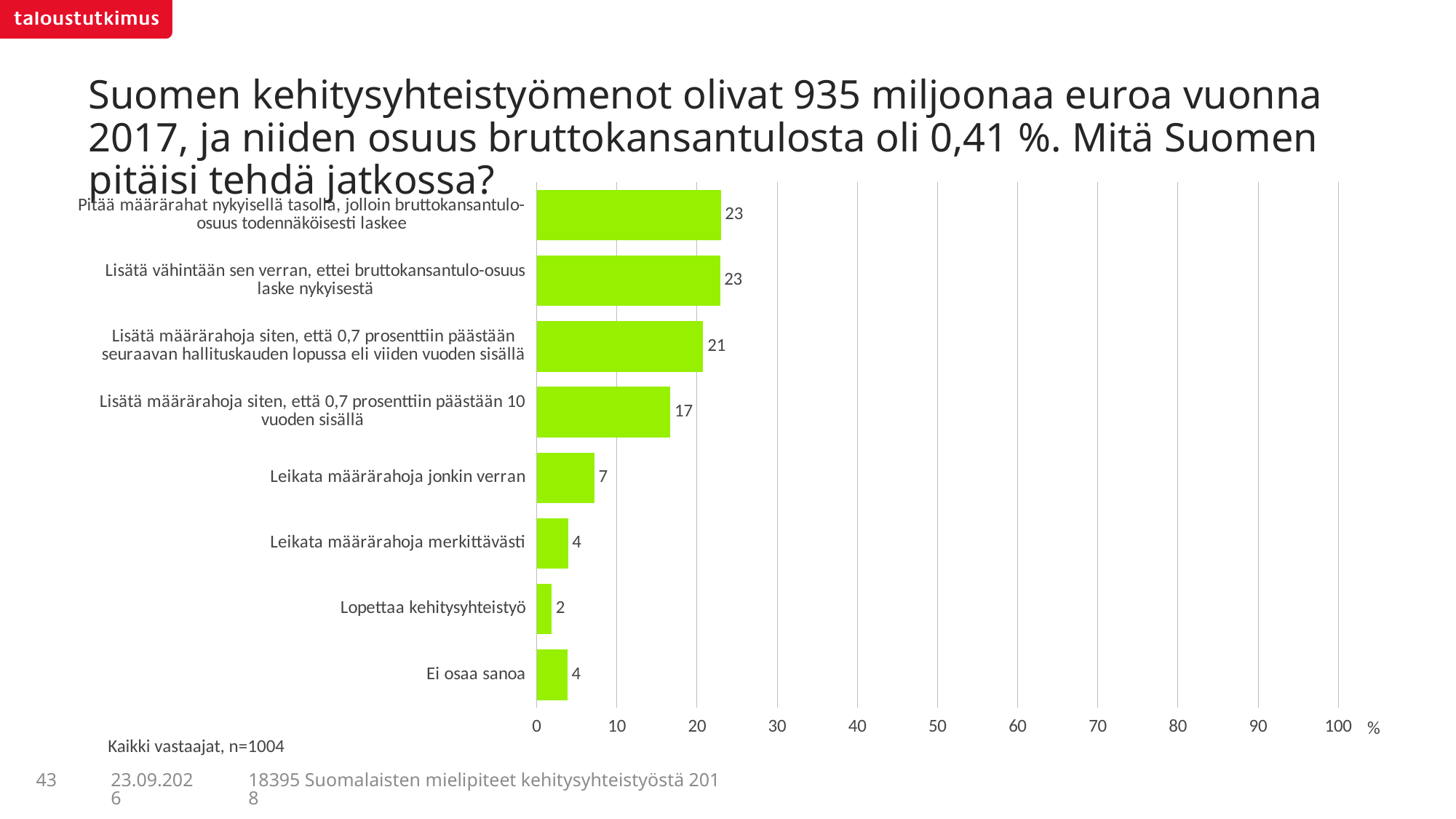
What is the difference between the values for "Lisätä vähintään sen verran, ettei bruttokansantulo-osuus laske nykyisestä" and "Lisätä määrärahoja siten, että 0,7 prosenttiin päästään 10 vuoden sisällä"? 6 Is the value for "Pitää määrärahat nykyisellä tasolla, jolloin bruttokansantulo-osuus todennäköisesti laskee" greater or less than 30? less What percentage of respondents chose "Lisätä määrärahoja siten, että 0,7 prosenttiin päästään 10 vuoden sisällä"? 17 Which is larger: the value for "Leikata määrärahoja jonkin verran" or the value for "Lopettaa kehitysyhteistyö"? Leikata määrärahoja jonkin verran What is the value shown for "Leikata määrärahoja jonkin verran"? 7 Which category has the lowest value? Lopettaa kehitysyhteistyö What kind of chart is shown on the slide? bar chart What is the difference between the values for "Leikata määrärahoja jonkin verran" and "Leikata määrärahoja merkittävästi"? 3 What is the value shown for "Ei osaa sanoa"? 4 What is the highest tick value shown on the horizontal axis? 100 How many categories are shown in the bar chart? 8 What is the value shown for "Lisätä määrärahoja siten, että 0,7 prosenttiin päästään seuraavan hallituskauden lopussa eli viiden vuoden sisällä"? 21